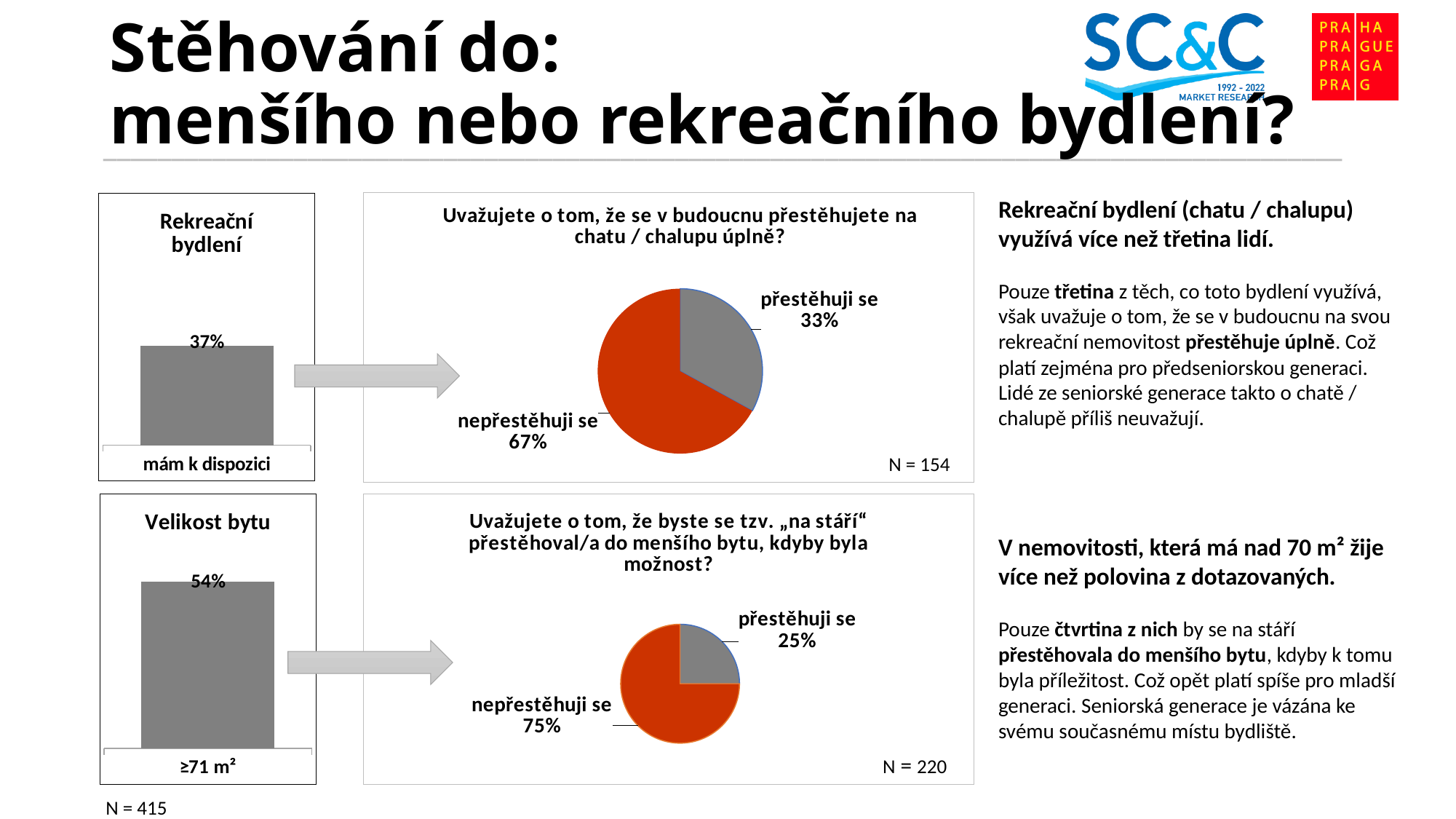
In the pie chart about moving to a smaller flat 'na stáří', what share is 'nepřestěhuji se'? 75% What type of chart is used for the question about moving to a chata / chalupa completely? Pie chart In the pie chart about moving to a smaller flat 'na stáří', what is the difference between 'nepřestěhuji se' and 'přestěhuji se'? 50 percentage points In the pie chart about moving to a chata / chalupa completely, which slice is the largest? nepřestěhuji se In the pie chart about moving to a chata / chalupa completely, what share is 'přestěhuji se'? 33% How many slices does the pie chart about moving to a smaller flat 'na stáří' have? 2 Which is larger: the 'mám k dispozici' value in the 'Rekreační bydlení' chart or the '≥71 m²' value in the 'Velikost bytu' chart? ≥71 m² (54%) In the 'Velikost bytu' bar chart, what is the value for '≥71 m²'? 54% In the 'Rekreační bydlení' bar chart, what is the value for 'mám k dispozici'? 37% In the pie chart about moving to a chata / chalupa completely, what share is 'nepřestěhuji se'? 67% In the pie chart about moving to a smaller flat 'na stáří', which slice is the smallest? přestěhuji se